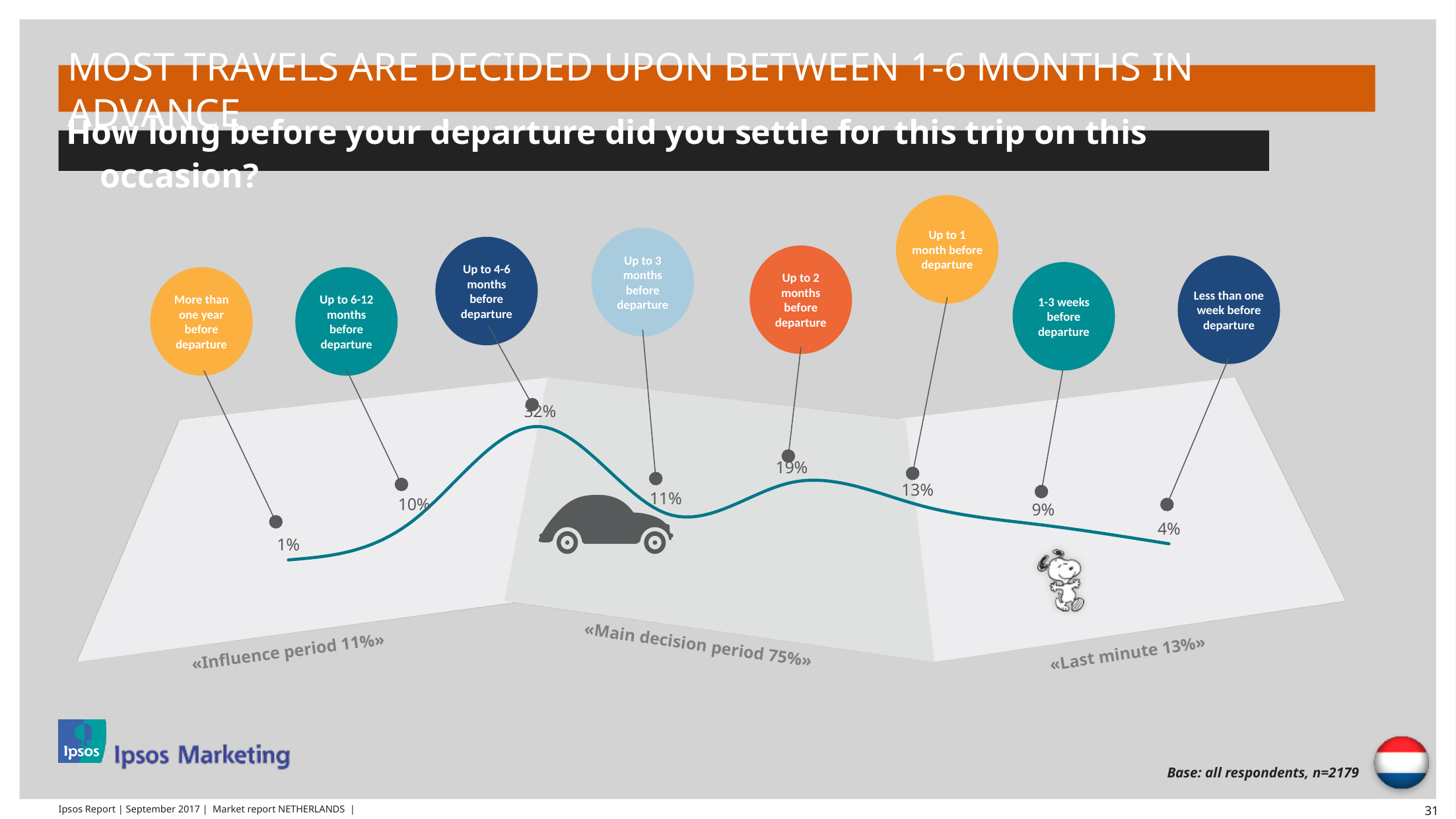
What percentage of respondents settled for the trip up to 2 months before departure? 19% What percentage of respondents settled for the trip more than one year before departure? 1% What is the difference in percentage points between 'Up to 2 months before departure' and 'Up to 3 months before departure'? 8 How many time-period categories are plotted on the chart? 8 What percentage of respondents settled for the trip up to 4-6 months before departure? 32% Which is larger: the percentage for 'Up to 6-12 months before departure' or for '1-3 weeks before departure'? Up to 6-12 months before departure Which time period before departure has the lowest percentage of respondents? More than one year before departure What kind of chart is used to show the percentages across the time periods? Line chart Which time period before departure has the highest percentage of respondents? Up to 4-6 months before departure What is the base (number of respondents) stated on the slide? n=2179 What percentage of respondents settled for the trip less than one week before departure? 4% What percentage is given for the 'Main decision period' on the chart? 75%